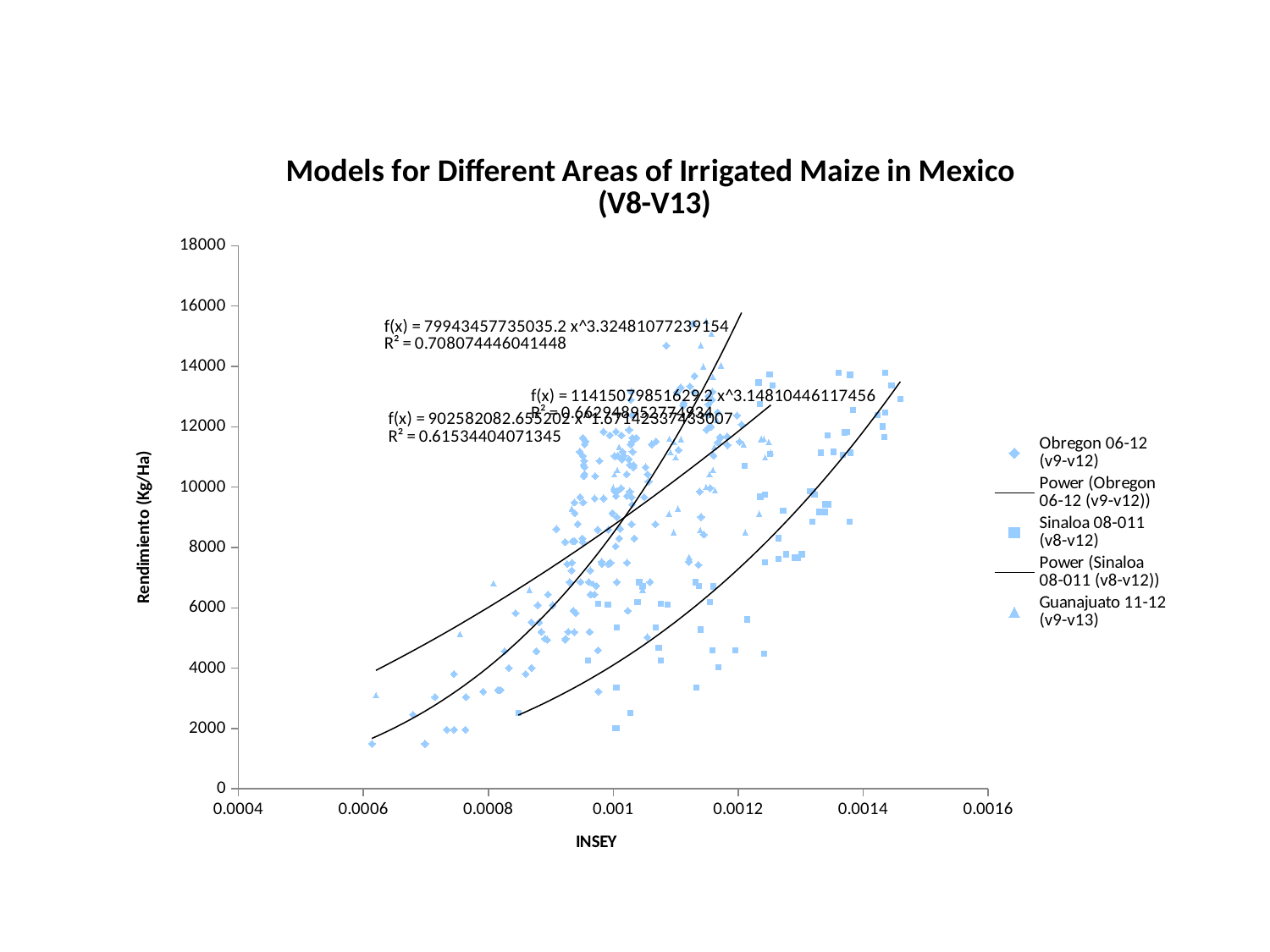
What is the title of the chart? Models for Different Areas of Irrigated Maize in Mexico (V8-V13) What is the exponent in the topmost fitted equation, f(x) = 79943457735035.2 x^? 3.32481077239154 What is the label of the x axis? INSEY What is the maximum value shown on the y axis? 18000 What kind of chart is shown on the slide? Scatter chart What is the exponent in the fitted equation that begins f(x) = 902582082.655202 x^? 1.67142337433007 What is the label of the y axis? Rendimiento (Kg/Ha) What is the minimum value shown on the x axis? 0.0004 What is the highest R² value printed on the chart? 0.708074446041448 How many entries does the chart's legend list? 5 What is the lowest R² value printed on the chart? 0.61534404071345 Which legend entry uses triangle markers? Guanajuato 11-12 (v9-v13)